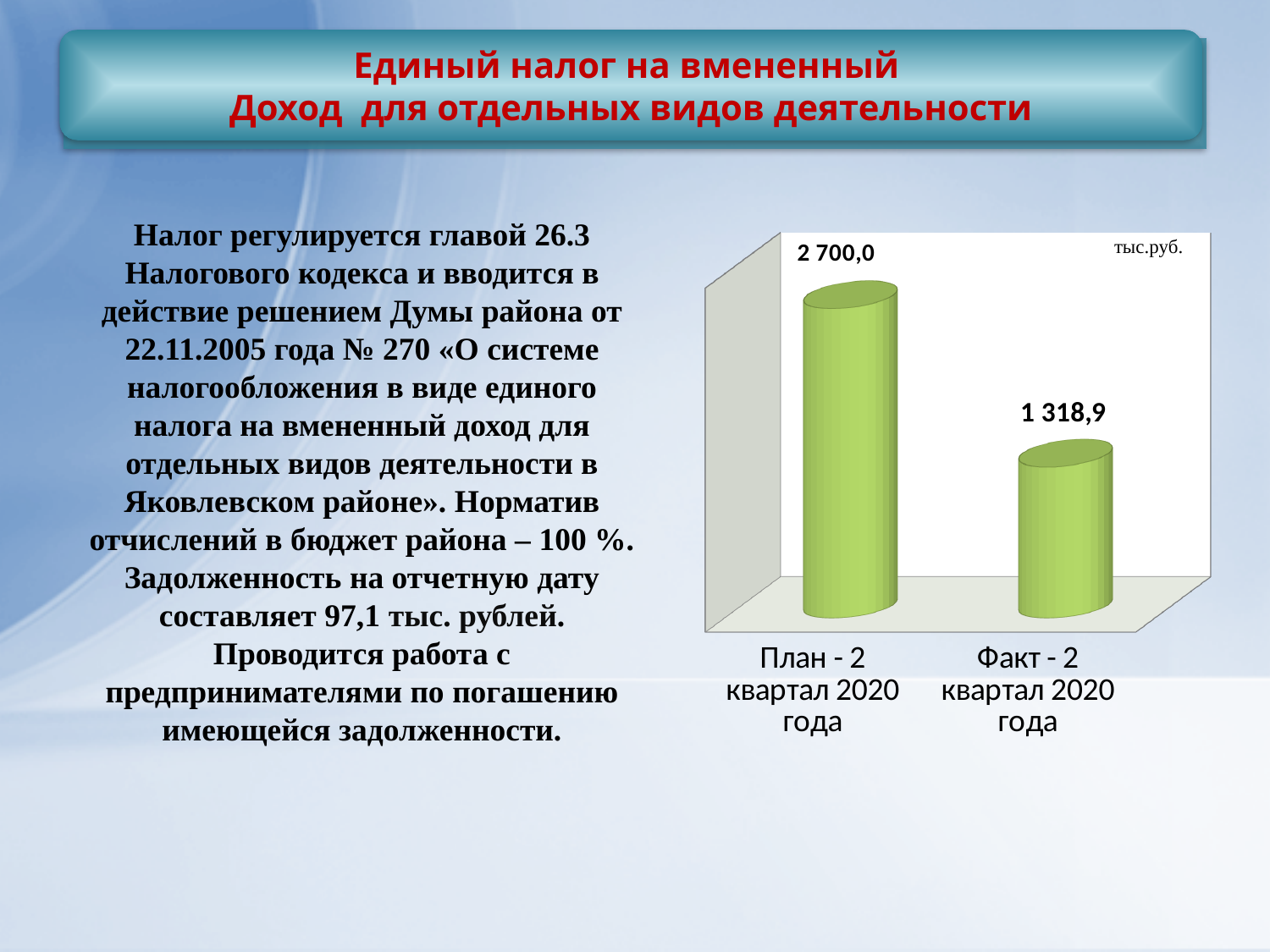
What is the value for План - 2 квартал 2020 года? 2 700,0 What is the difference between the План and Факт values for 2 квартал 2020 года? 1 381,1 What colour are the bars in the chart? green What unit is indicated in the top right corner of the chart? тыс.руб. How many categories are shown in the chart? 2 What kind of chart is shown on the slide? bar chart Which category has the lowest value? Факт - 2 квартал 2020 года Do the values rise or fall from the first bar to the second bar? fall Which is larger, the value for План - 2 квартал 2020 года or the value for Факт - 2 квартал 2020 года? План - 2 квартал 2020 года What is the value for Факт - 2 квартал 2020 года? 1 318,9 Which category has the highest value? План - 2 квартал 2020 года